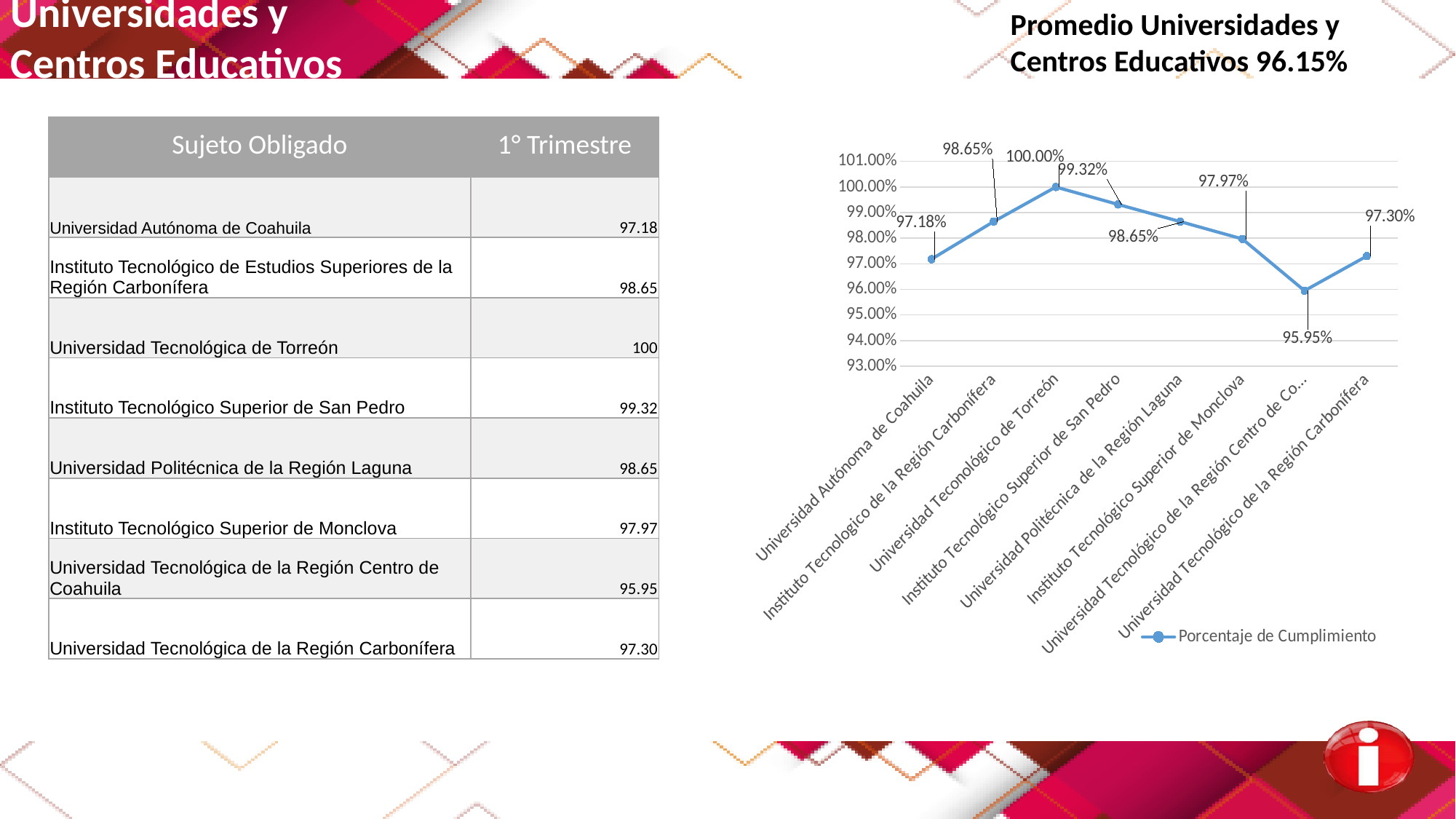
Is the value for Universidad Tecnológica de la Región Centro de Coahuila greater or less than 97.00%? less What is the Porcentaje de Cumplimiento for Instituto Tecnológico Superior de Monclova? 97.97% Which is larger, the Porcentaje de Cumplimiento for Instituto Tecnológico Superior de San Pedro or for Instituto Tecnológico Superior de Monclova? Instituto Tecnológico Superior de San Pedro What type of chart is shown on the slide? line chart How many series does the chart legend list? 1 How many categories are plotted on the chart? 8 What is the Porcentaje de Cumplimiento for Universidad Tecnológica de Torreón? 100.00% Which category has the lowest Porcentaje de Cumplimiento? Universidad Tecnológica de la Región Centro de Coahuila What is the Porcentaje de Cumplimiento for Instituto Tecnológico Superior de San Pedro? 99.32% What is the Porcentaje de Cumplimiento for Universidad Autónoma de Coahuila? 97.18% What is the difference between the Porcentaje de Cumplimiento of Universidad Tecnológica de Torreón and Universidad Tecnológica de la Región Centro de Coahuila? 4.05% Which category has the highest Porcentaje de Cumplimiento? Universidad Tecnológica de Torreón